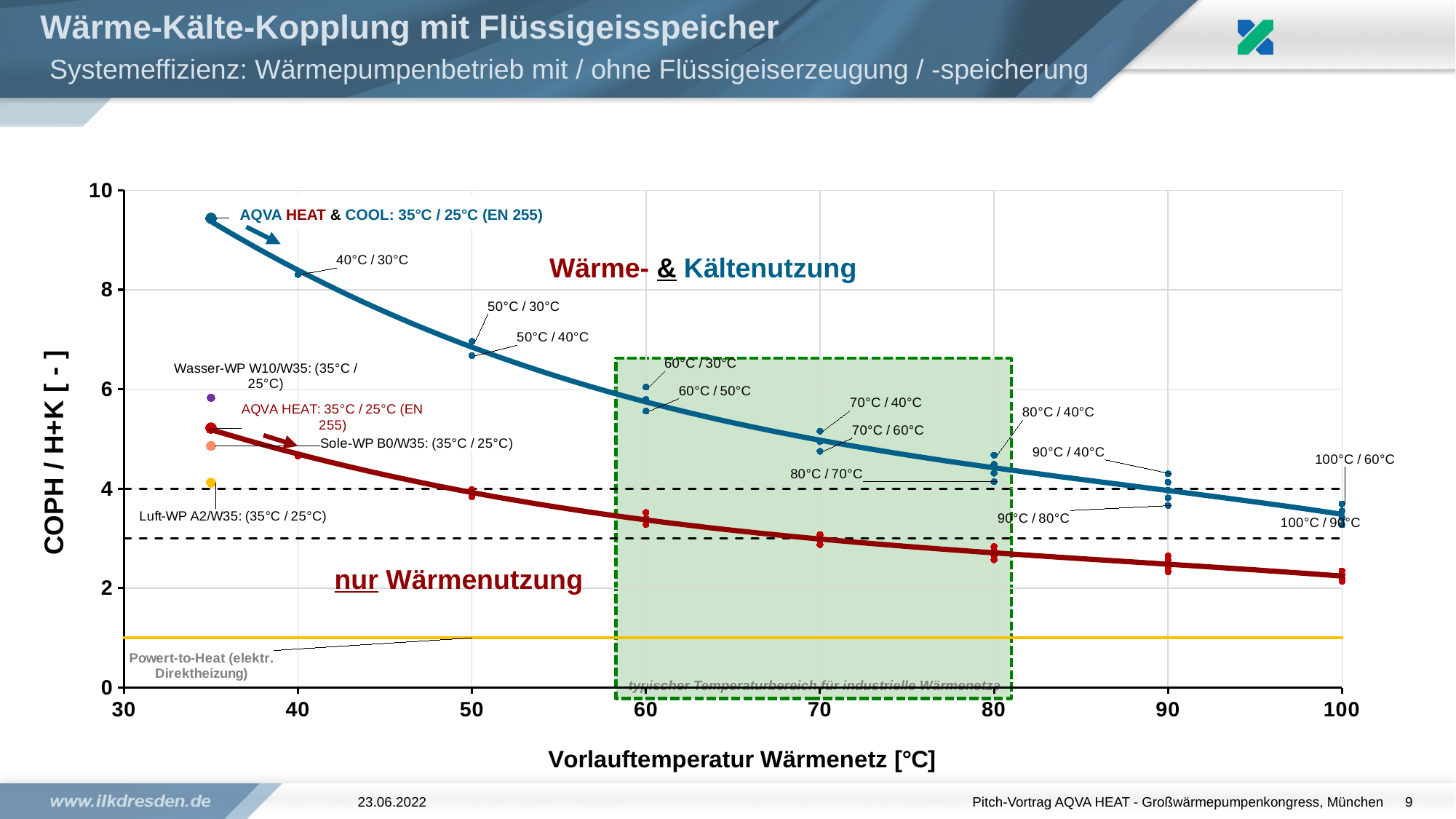
Which is larger: the value for Sole-WP B0/W35 or the value for Luft-WP A2/W35? Sole-WP B0/W35 Is the yellow 'Powert-to-Heat (elektr. Direktheizung)' line greater or less than 2? less Is the value of the blue 'Wärme- & Kältenutzung' curve at 35 °C greater or less than 9? greater As the Vorlauftemperatur increases from 35 to 100 °C, does the red 'nur Wärmenutzung' curve rise or fall? fall Is the value of the red 'nur Wärmenutzung' curve at 60 °C greater or less than 4? less What kind of chart is shown on the slide? line chart What is the title of the x axis of the chart? Vorlauftemperatur Wärmenetz [°C] As the Vorlauftemperatur increases from 35 to 100 °C, does the blue 'Wärme- & Kältenutzung' curve rise or fall? fall At 80 °C, which curve has the higher value: the blue 'Wärme- & Kältenutzung' curve or the red 'nur Wärmenutzung' curve? blue 'Wärme- & Kältenutzung' curve Among the single points plotted at 35 °C (Wasser-WP, Sole-WP, Luft-WP), which has the lowest value? Luft-WP A2/W35